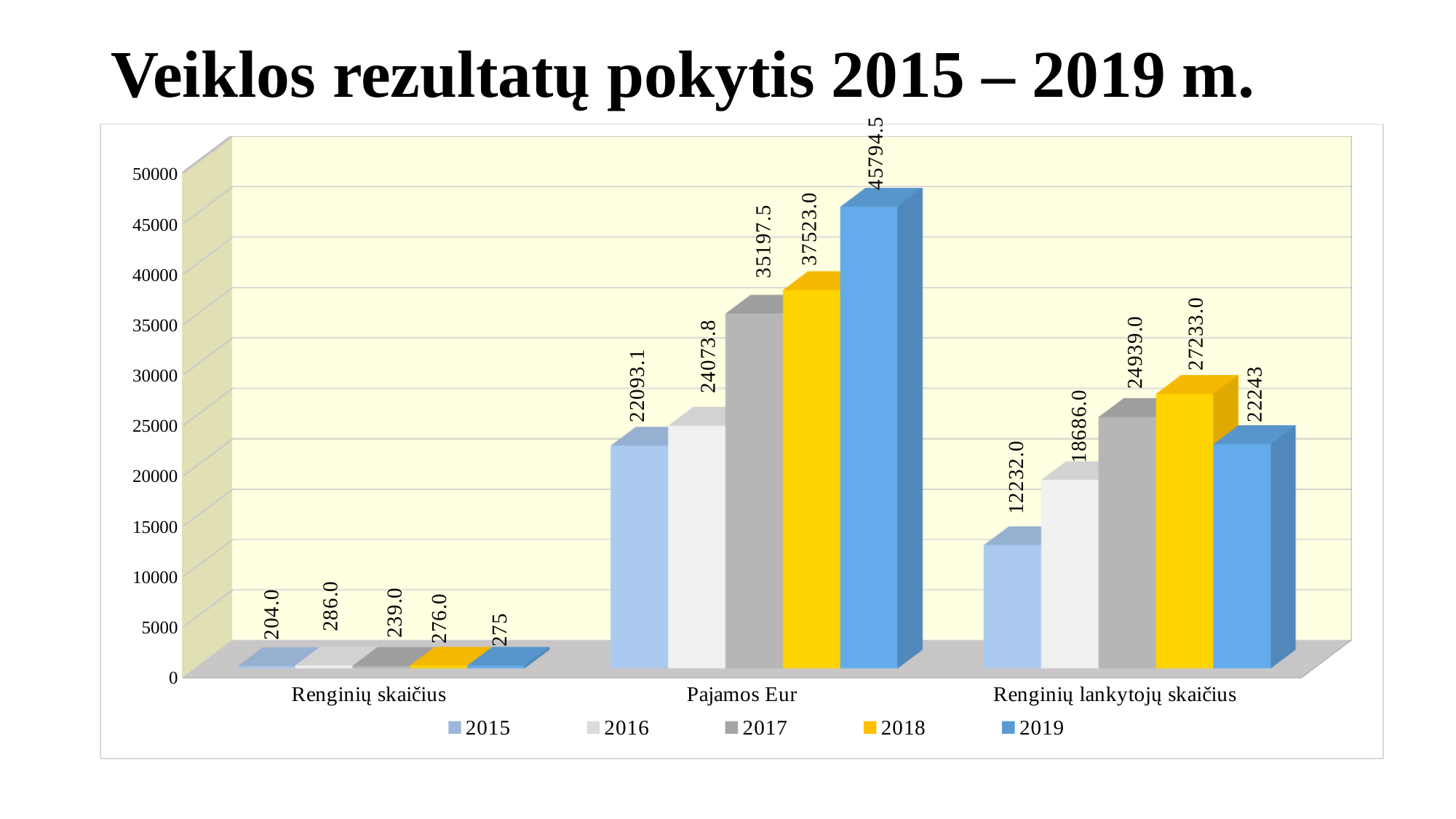
Which year has the lowest value in the Pajamos Eur category? 2015 What is the value for 2018 in the Renginių lankytojų skaičius category? 27233.0 What is the value for 2019 in the Pajamos Eur category? 45794.5 What is the difference between the 2019 and 2015 values in the Pajamos Eur category? 23701.4 What is the value for 2016 in the Renginių skaičius category? 286.0 How many categories are shown on the x axis? 3 Which year has the highest value in the Renginių lankytojų skaičius category? 2018 Do the Pajamos Eur values rise or fall from 2015 to 2019? Rise Which is larger in the Renginių lankytojų skaičius category: the 2017 value or the 2019 value? 2017 What kind of chart is shown on the slide? Bar chart Is the 2017 value for Pajamos Eur greater or less than 30000? greater How many series does the legend list? 5